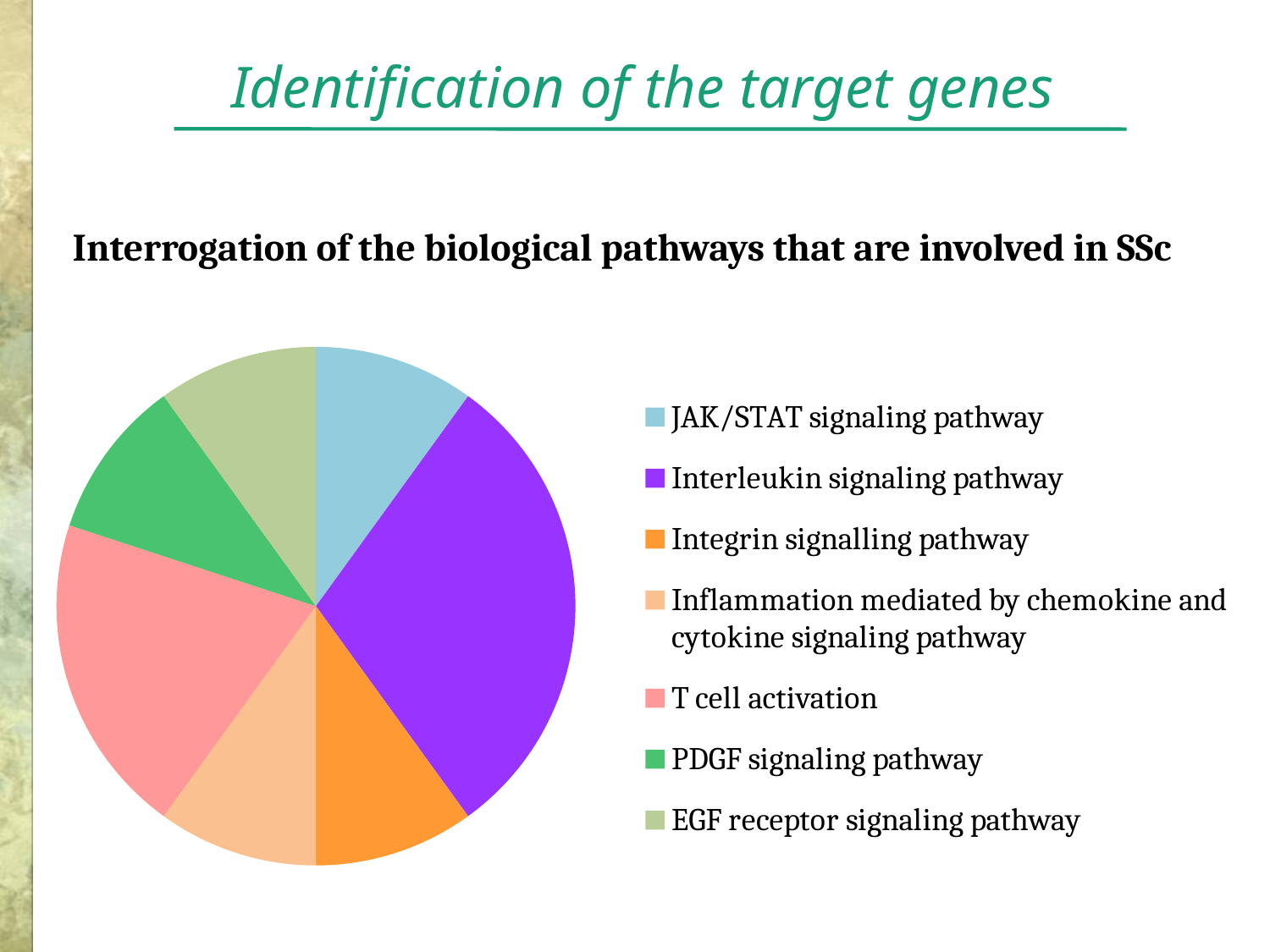
Which slice is larger: T cell activation or EGF receptor signaling pathway? T cell activation What colour is the slice for the Interleukin signaling pathway? purple What kind of chart is shown on the slide? pie chart Which pathway has the second-largest slice in the pie chart? T cell activation Which pathway has the largest slice in the pie chart? Interleukin signaling pathway How many entries does the legend of the pie chart list? 7 Which slice is larger: T cell activation or PDGF signaling pathway? T cell activation Which slice is larger: Interleukin signaling pathway or T cell activation? Interleukin signaling pathway How many slices does the pie chart have? 7